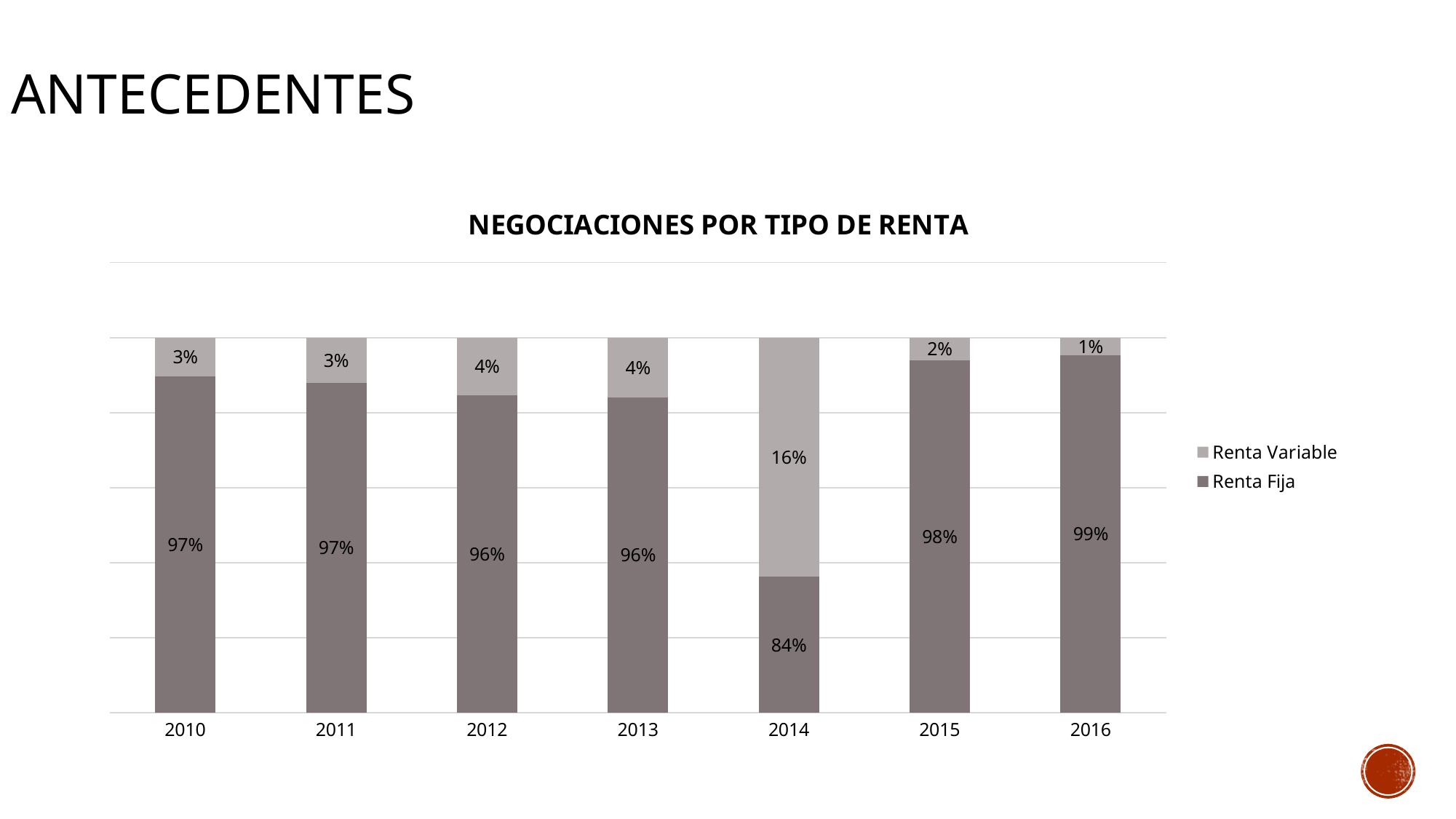
How many series does the legend list? 2 What is the value for Renta Variable in 2012? 4% Which is larger, the Renta Variable value for 2014 or for 2013? 2014 In which year is the Renta Variable value lowest? 2016 How many years are shown on the x axis? 7 What is the value for Renta Variable in 2016? 1% What kind of chart is shown on the slide? Stacked bar chart In which year is the Renta Fija value lowest? 2014 What is the value for Renta Fija in 2014? 84% In which year is the Renta Variable value highest? 2014 What is the difference between the Renta Fija values for 2016 and 2014? 15% What is the value for Renta Fija in 2015? 98%